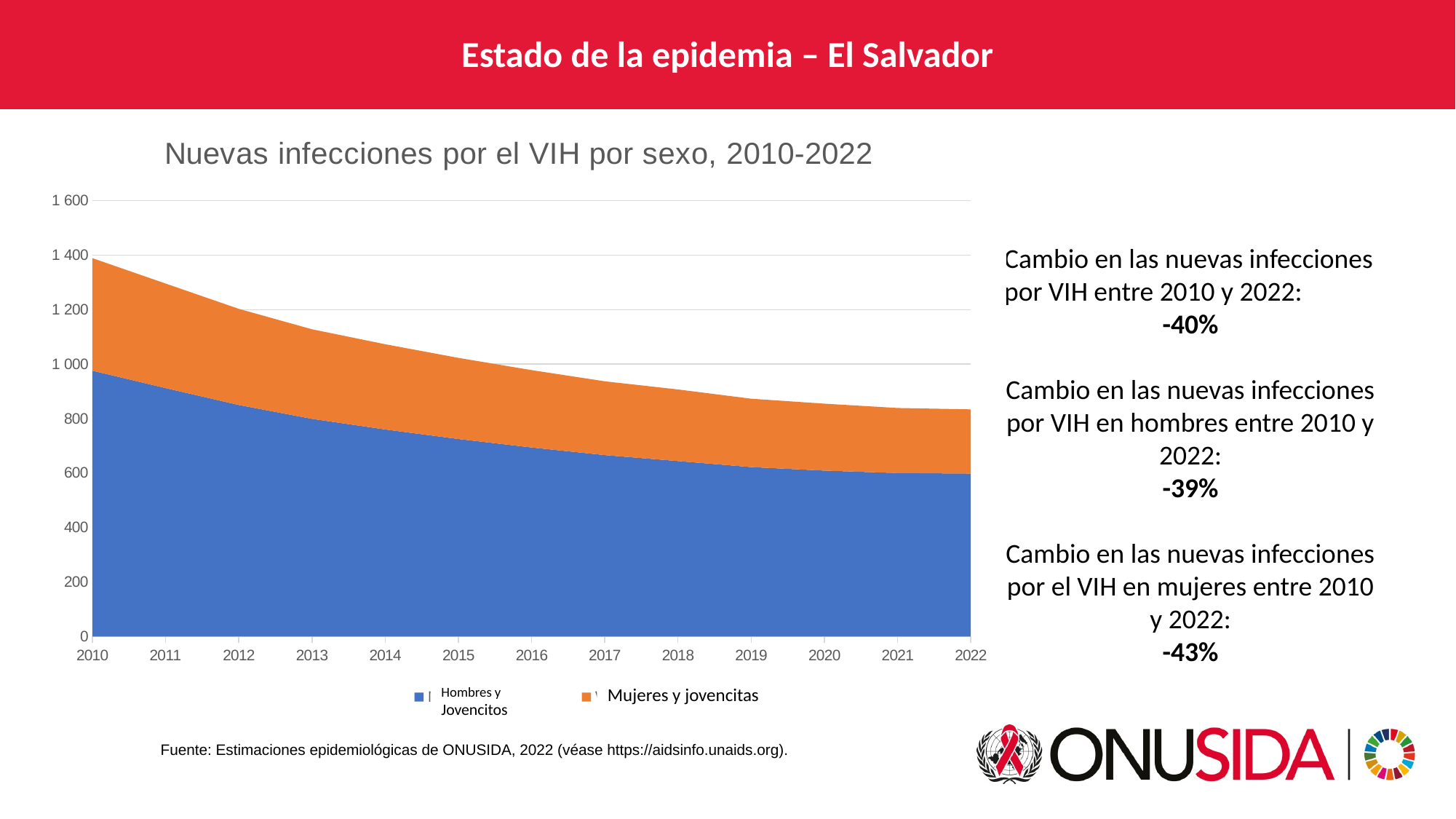
How many years are plotted along the x axis of the chart? 13 What kind of chart is shown on the slide? Area chart What is the title of the chart? Nuevas infecciones por el VIH por sexo, 2010-2022 In 2022, which series has the larger value: Hombres y Jovencitos or Mujeres y jovencitas? Hombres y Jovencitos Is the value for Hombres y Jovencitos in 2016 greater or less than 600? greater How many series does the chart legend list? 2 Is the total value for 2010 greater or less than 1 200? greater In which year is the total of new HIV infections lowest in the chart? 2022 Is the total value for 2022 greater or less than 800? greater Which series is shown in orange in the chart? Mujeres y jovencitas Do total new HIV infections rise or fall from 2010 to 2022 in the chart? Fall In which year is the total of new HIV infections highest in the chart? 2010